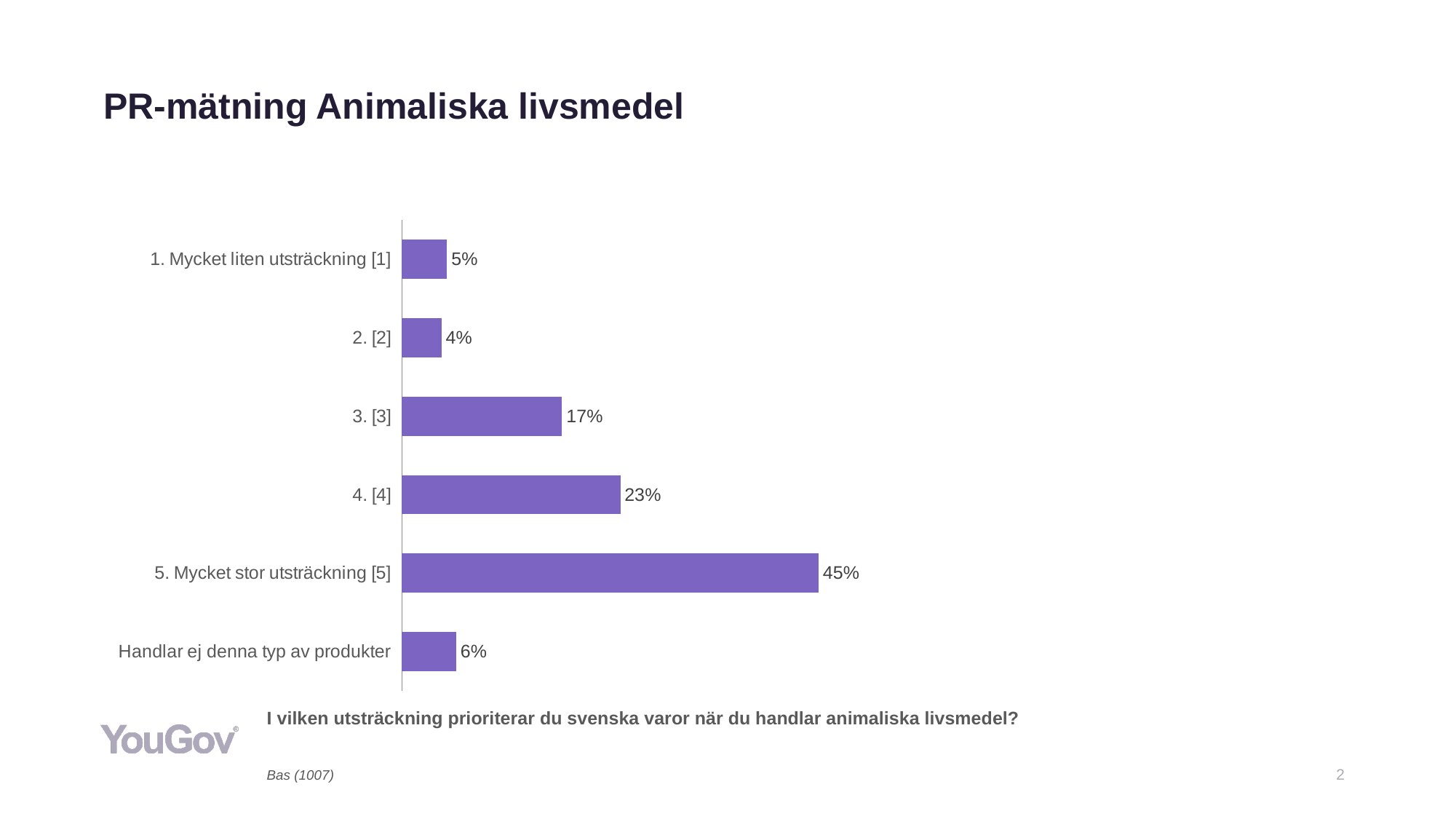
How many categories are shown in the chart? 6 What is the value for "3. [3]"? 17% What is the difference between the values for "5. Mycket stor utsträckning [5]" and "4. [4]"? 22% What is the value for "1. Mycket liten utsträckning [1]"? 5% What is the value for "Handlar ej denna typ av produkter"? 6% Which category has the lowest value? 2. [2] Which category has the highest value? 5. Mycket stor utsträckning [5] What survey question is shown below the chart? I vilken utsträckning prioriterar du svenska varor när du handlar animaliska livsmedel? Which is larger, the value for "Handlar ej denna typ av produkter" or the value for "2. [2]"? Handlar ej denna typ av produkter What is the difference between the values for "4. [4]" and "3. [3]"? 6% What is the value for "5. Mycket stor utsträckning [5]"? 45% What kind of chart is shown on the slide? Bar chart